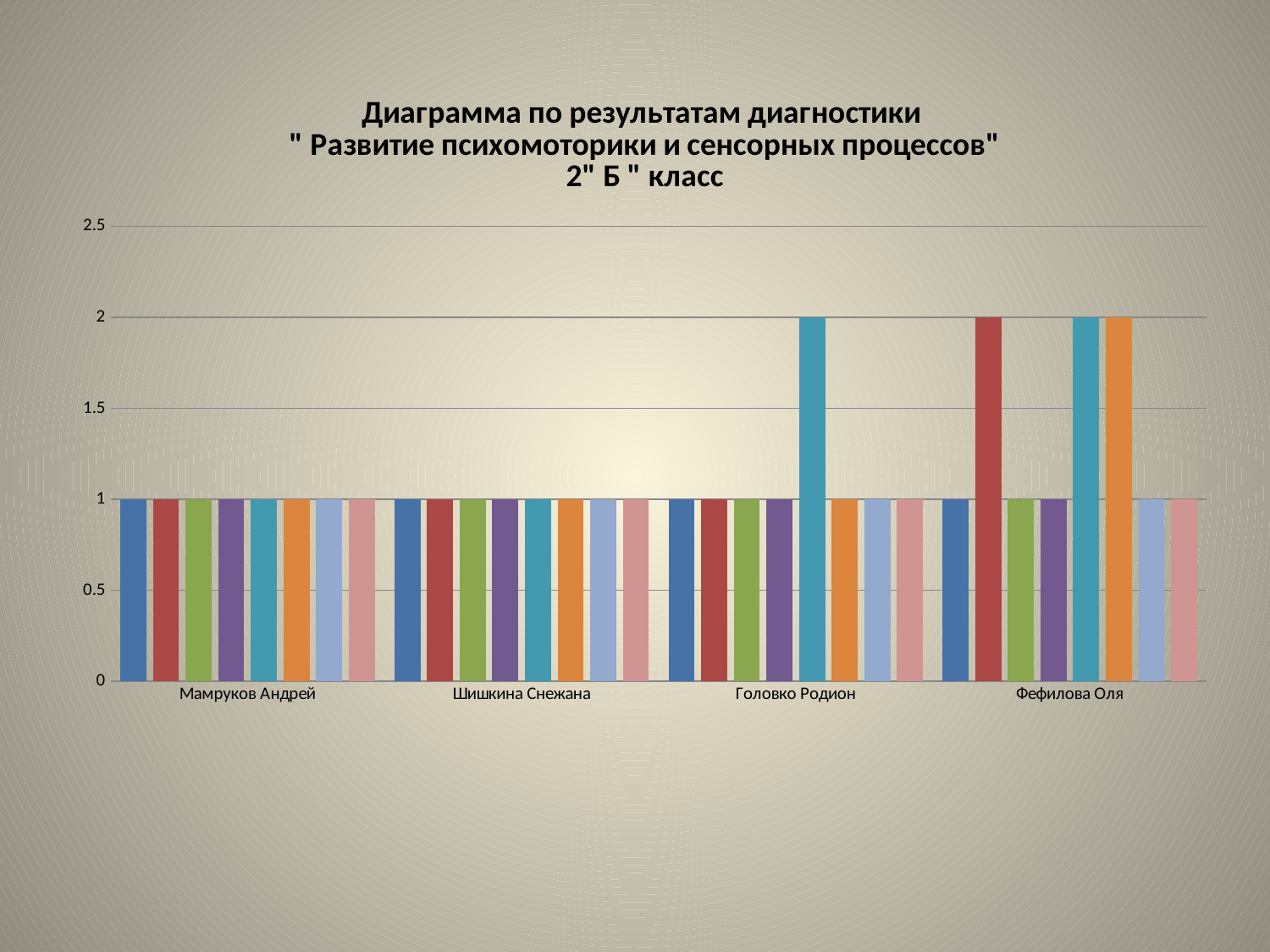
What kind of chart is shown on the slide? bar chart Which student has the most bars reaching the value 2? Фефилова Оля How many bars for Фефилова Оля reach the value 2? 3 What is the difference between the teal bar for Головко Родион and the teal bar for Мамруков Андрей? 1 What value does the teal bar for Головко Родион reach? 2 What value do all the bars for Шишкина Снежана reach? 1 How many bars are plotted for each student? 8 Is the highest bar for Мамруков Андрей greater or less than 1.5? less Which is larger: the orange bar for Фефилова Оля or the orange bar for Шишкина Снежана? Фефилова Оля What is the title of the chart? Диаграмма по результатам диагностики " Развитие психомоторики и сенсорных процессов" 2" Б " класс What is the highest value shown on the vertical axis? 2.5 How many students (categories) are shown on the x axis? 4